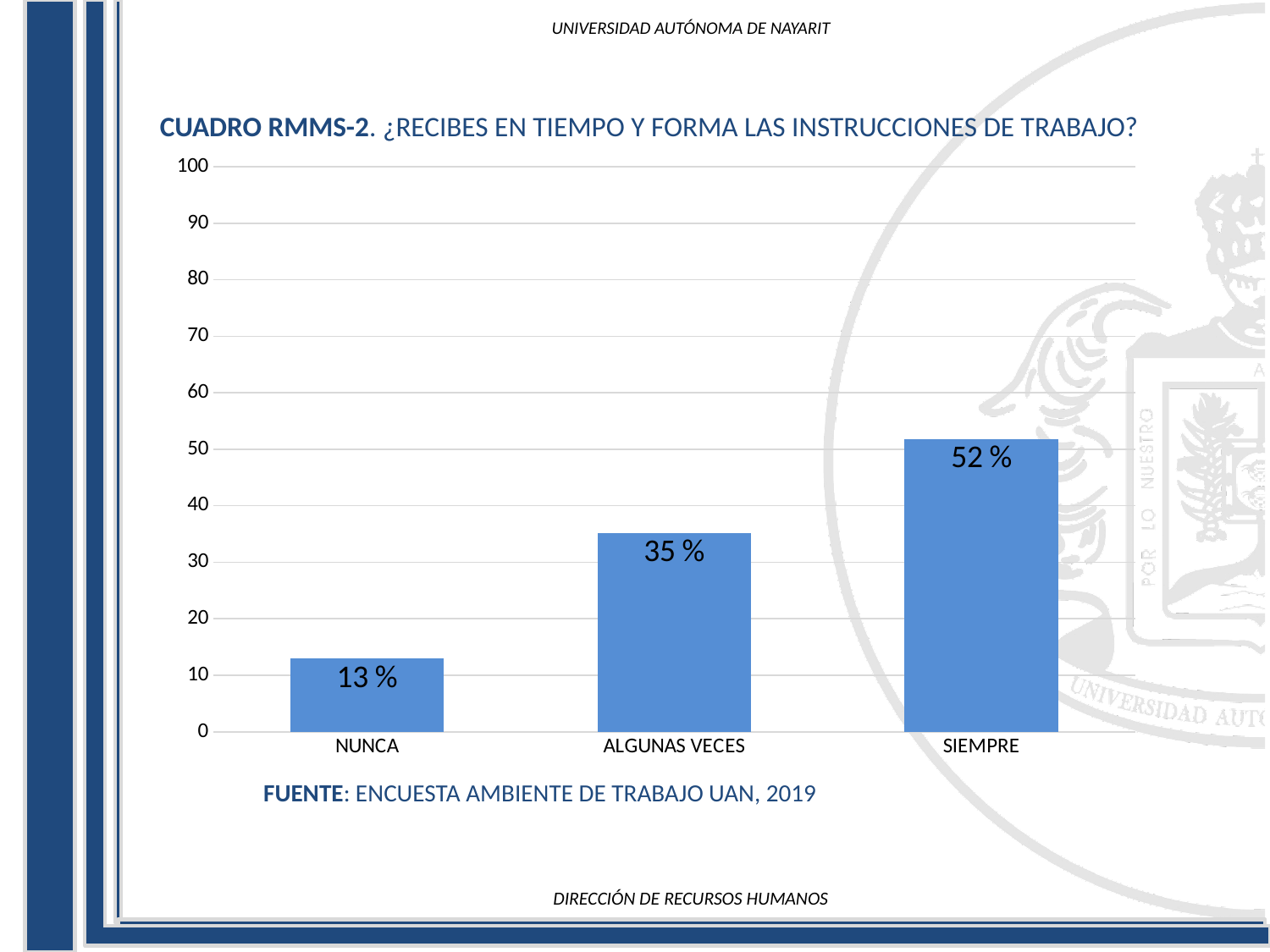
What is the difference between the values for ALGUNAS VECES and NUNCA? 22 % What source is cited below the chart? ENCUESTA AMBIENTE DE TRABAJO UAN, 2019 What is the difference between the values for SIEMPRE and ALGUNAS VECES? 17 % What is the value for SIEMPRE? 52 % Which category has the lowest value? NUNCA Which is larger, the value for NUNCA or the value for ALGUNAS VECES? ALGUNAS VECES What is the value for NUNCA? 13 % What kind of chart is shown on the slide? bar chart How many categories are shown on the x axis? 3 Which category has the highest value? SIEMPRE What is the value for ALGUNAS VECES? 35 % Is the value for SIEMPRE greater or less than 50? greater